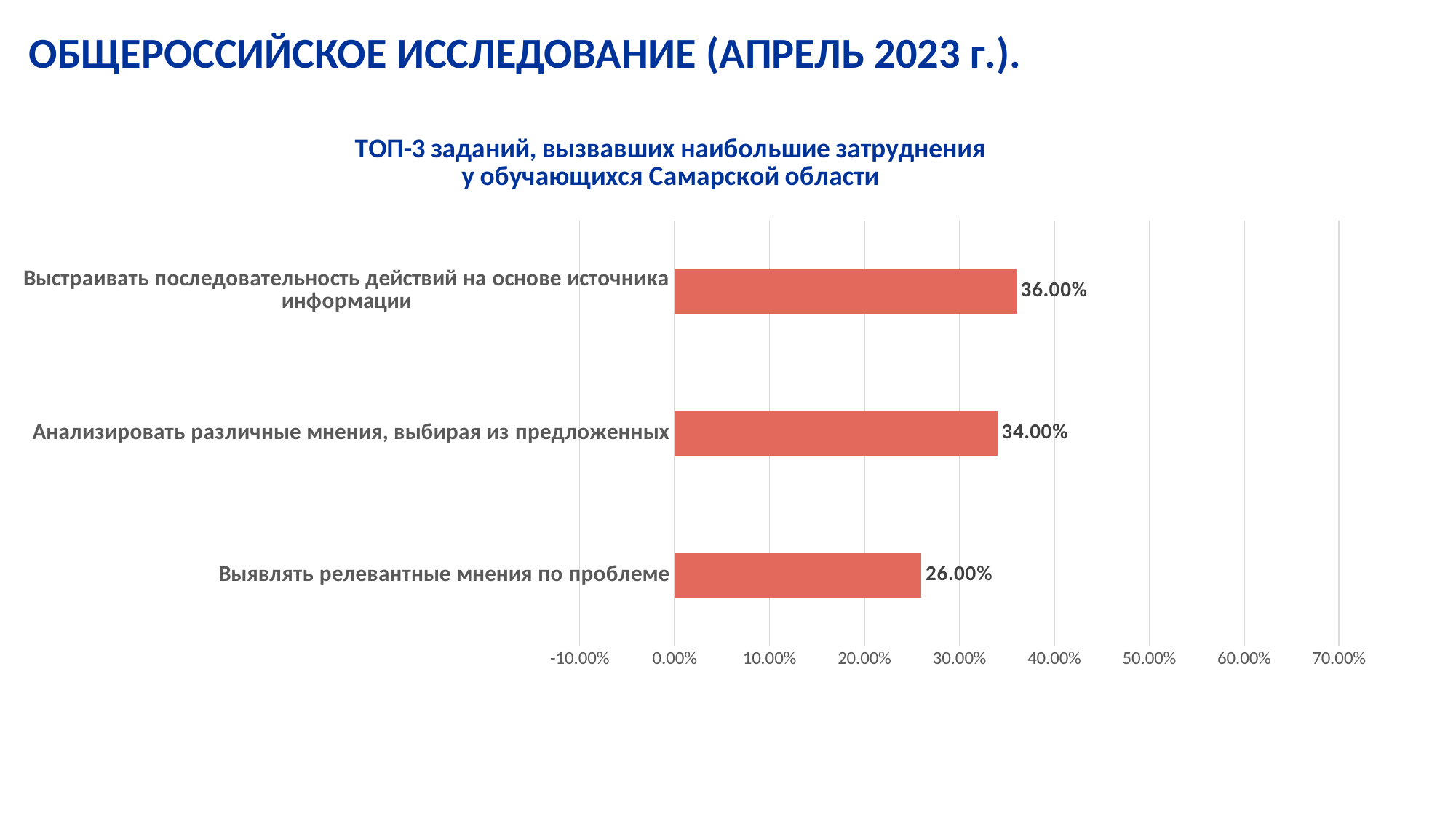
What kind of chart is shown on the slide? bar chart What is the difference between the values for "Выстраивать последовательность действий на основе источника информации" and "Выявлять релевантные мнения по проблеме"? 10.00% Which is larger: the value for "Анализировать различные мнения, выбирая из предложенных" or for "Выявлять релевантные мнения по проблеме"? Анализировать различные мнения, выбирая из предложенных Is the value for "Выявлять релевантные мнения по проблеме" greater or less than 30.00%? less What is the value for "Выстраивать последовательность действий на основе источника информации"? 36.00% How many categories are shown in the chart? 3 Which category has the lowest value? Выявлять релевантные мнения по проблеме What is the title of the chart? ТОП-3 заданий, вызвавших наибольшие затруднения у обучающихся Самарской области Which category has the highest value? Выстраивать последовательность действий на основе источника информации What is the value for "Анализировать различные мнения, выбирая из предложенных"? 34.00% What is the difference between the values for "Анализировать различные мнения, выбирая из предложенных" and "Выявлять релевантные мнения по проблеме"? 8.00% What is the value for "Выявлять релевантные мнения по проблеме"? 26.00%